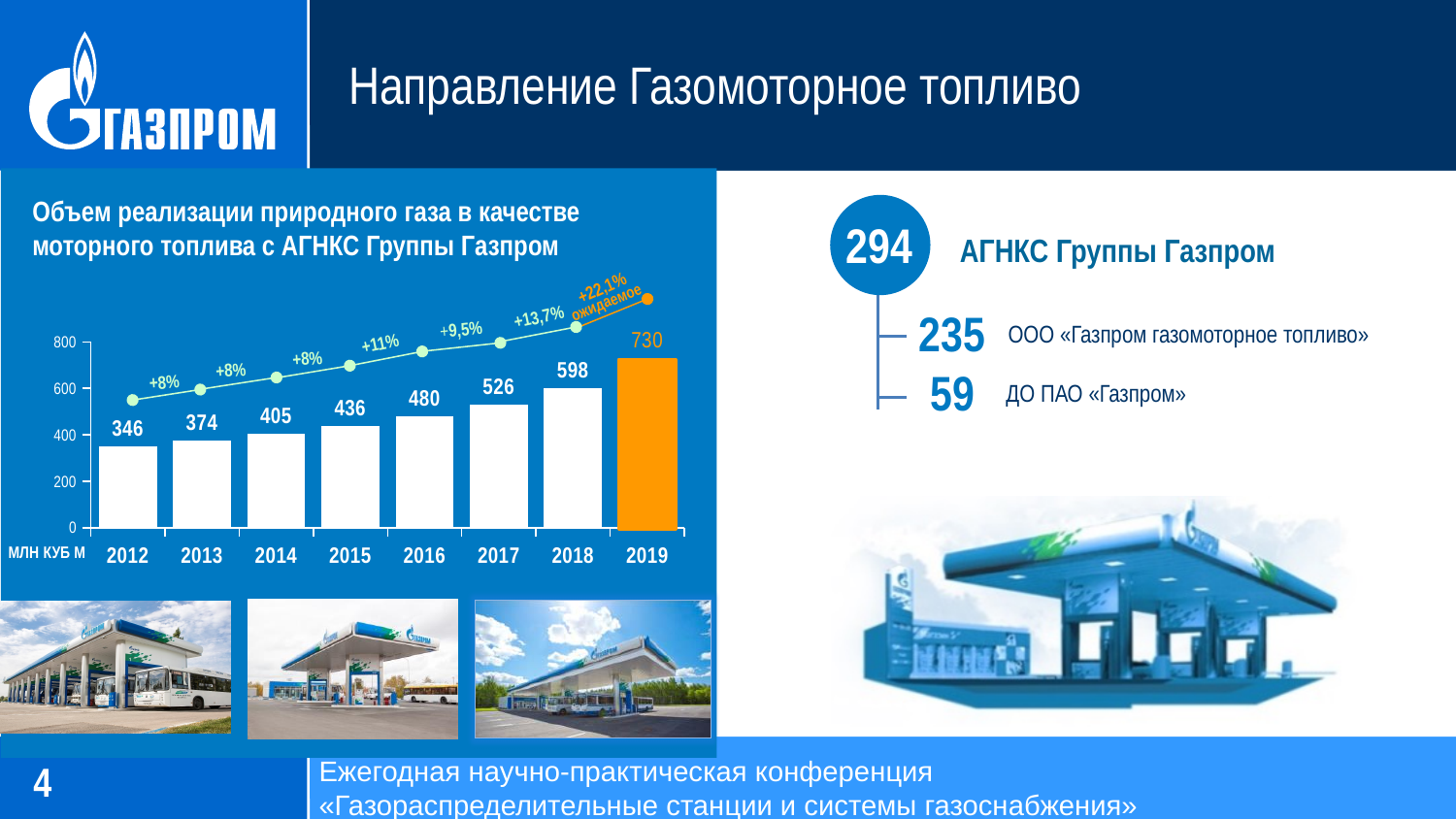
Which year has the highest value on the chart? 2019 Which year has the lowest value on the chart? 2012 What is the difference between the 2018 value and the 2017 value? 72 What is the value for 2012 on the chart? 346 How many years are shown on the x axis of the chart? 8 What kind of chart is shown on the slide? bar chart Which is larger, the value for 2016 or the value for 2015? 2016 Is the value for 2018 greater or less than 400? greater Do the values rise or fall from 2012 to 2019? rise What is the expected value for 2019 on the chart? 730 What is the value for 2017 on the chart? 526 What growth percentage is labelled between 2017 and 2018 on the chart? +13,7%